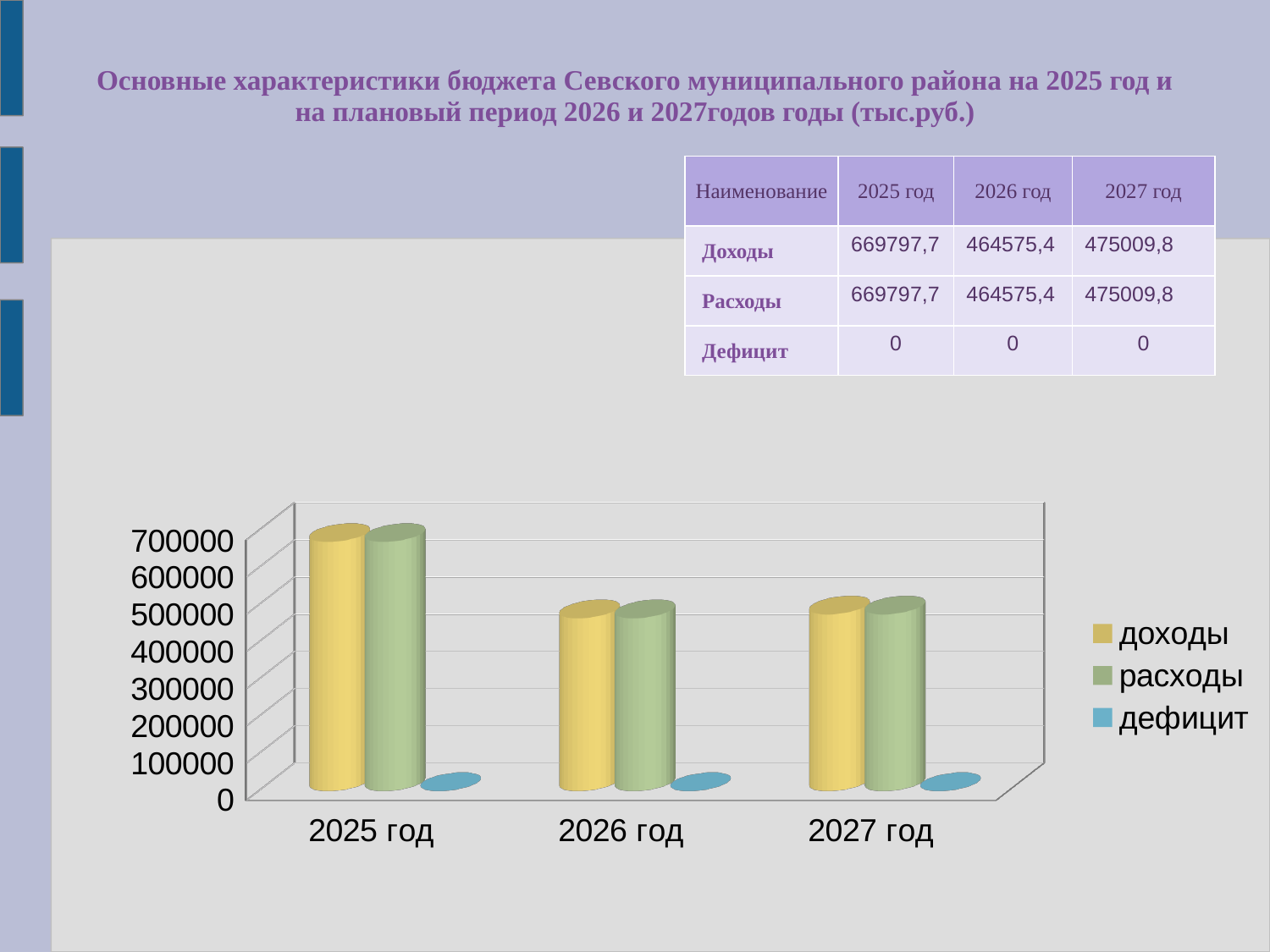
Is the value of доходы for 2025 год greater or less than 600000? greater What is the value of расходы for 2026 год? 464575,4 In which year is the value of доходы highest? 2025 год Is the value of расходы for 2026 год greater or less than 500000? less In which year is the value of доходы lowest? 2026 год How many year categories are shown on the x axis of the chart? 3 What kind of chart is shown on the slide? bar chart What is the value of дефицит for 2027 год? 0 What is the value of доходы for 2025 год? 669797,7 What is the difference between доходы in 2025 год and доходы in 2026 год? 205222,3 How many series does the chart legend list? 3 Which is larger: доходы for 2027 год or доходы for 2026 год? 2027 год